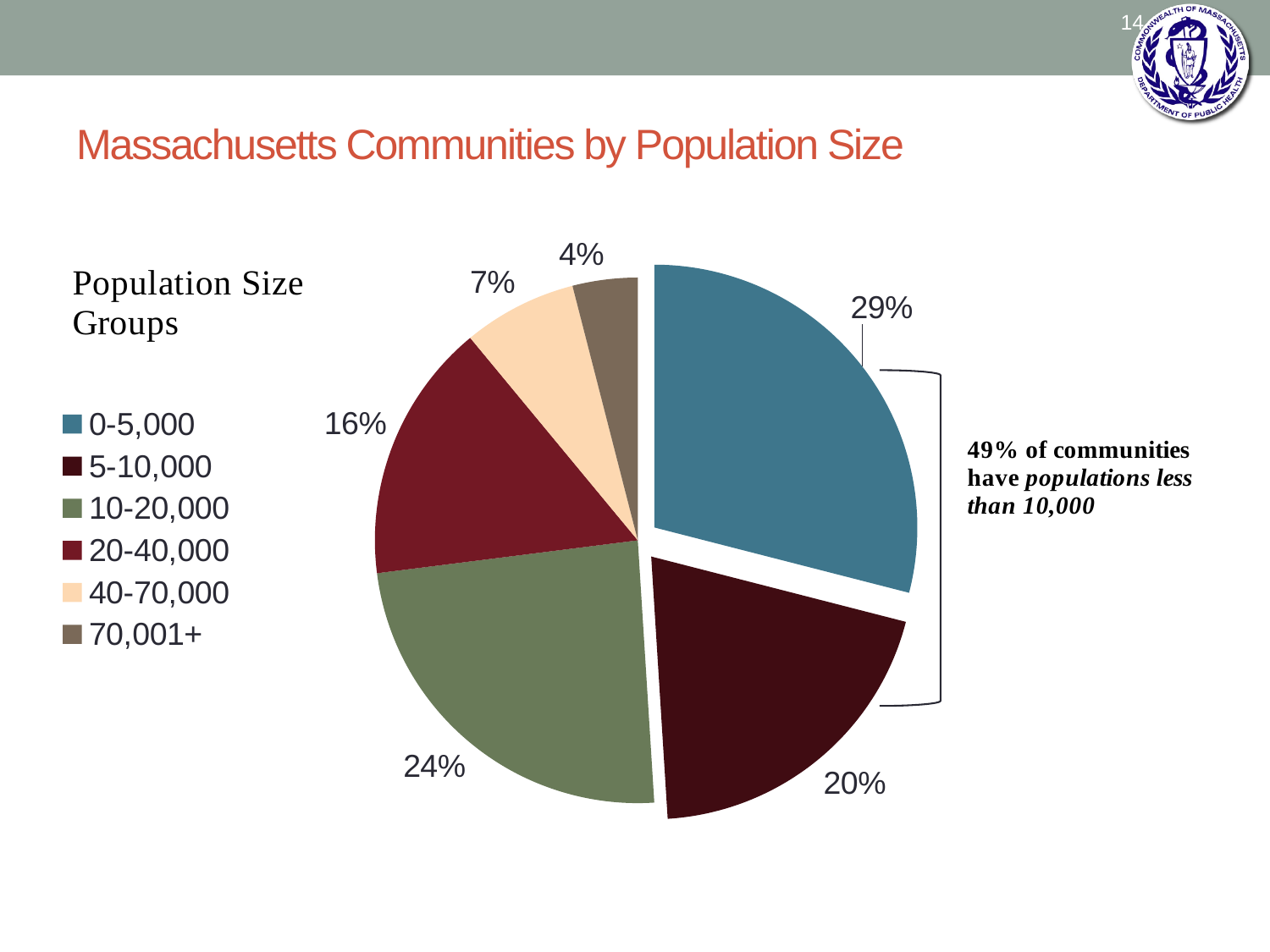
What share of communities falls in the 20-40,000 population size group? 16% What is the title of the chart on the slide? Massachusetts Communities by Population Size Which population size group has the largest share of communities? 0-5,000 How many population size groups are shown in the pie chart? 6 Which population size group has the smallest share of communities? 70,001+ What share of communities falls in the 5-10,000 population size group? 20% What is the difference in percentage points between the 0-5,000 group and the 40-70,000 group? 22 What share of communities falls in the 10-20,000 population size group? 24% Which group has a larger share: 10-20,000 or 20-40,000? 10-20,000 What share of communities falls in the 0-5,000 population size group? 29% What share of communities falls in the 70,001+ population size group? 4% What type of chart is shown on the slide? pie chart